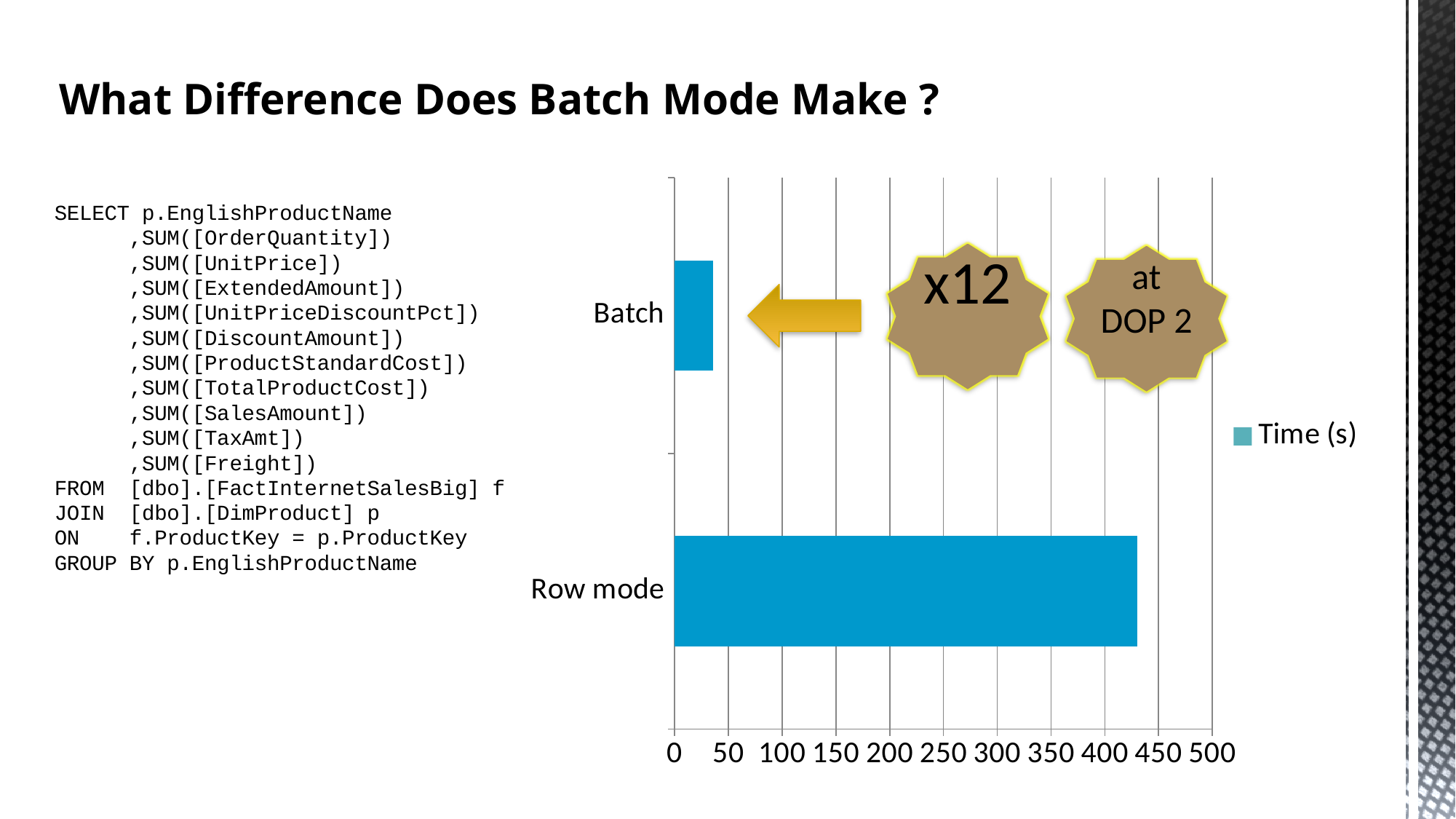
Is the Time (s) value for Batch greater or less than 50? less Which has a larger Time (s) value, Batch or Row mode? Row mode What is the name of the series shown in the chart legend? Time (s) What is the maximum value shown on the chart's horizontal axis? 500 Which category has the highest Time (s) value? Row mode What kind of chart is shown on the slide? bar chart How many series does the chart legend list? 1 Is the Time (s) value for Row mode greater or less than 450? less Is the Time (s) value for Row mode greater or less than 400? greater How many categories are plotted in the chart? 2 Which category has the lowest Time (s) value? Batch